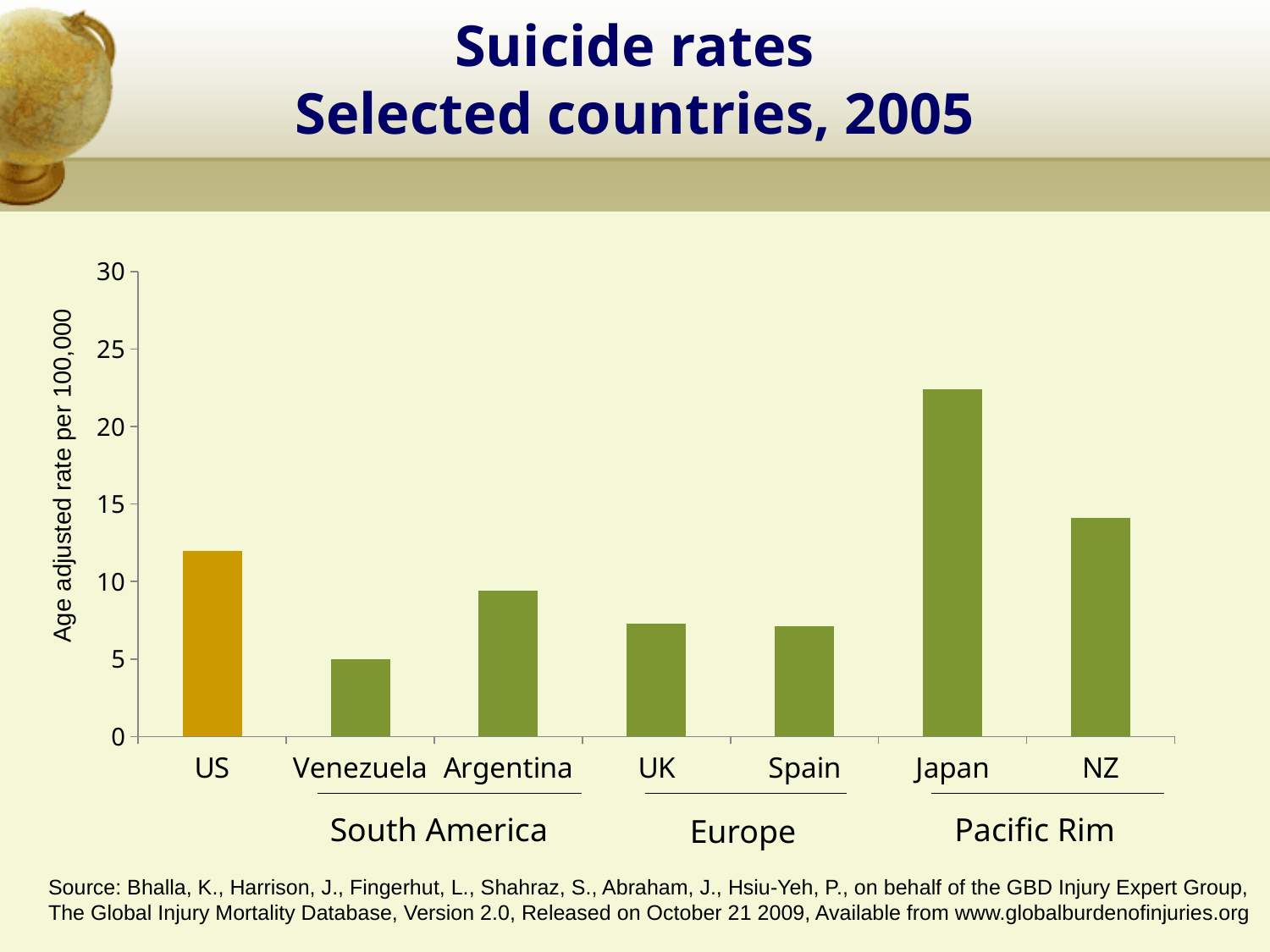
Is the value for Venezuela greater or less than 10? less Which country's bar is shown in a different colour (orange) from the others? US Is the value for Japan greater or less than 20? greater Is the value for NZ greater or less than 15? less Which country has the highest suicide rate in the chart? Japan Which country has the lowest suicide rate in the chart? Venezuela Which has the higher suicide rate, Japan or NZ? Japan What kind of chart is shown on the slide? bar chart Which has the higher suicide rate, US or Argentina? US What is the label on the vertical axis of the chart? Age adjusted rate per 100,000 How many countries are plotted in the chart? 7